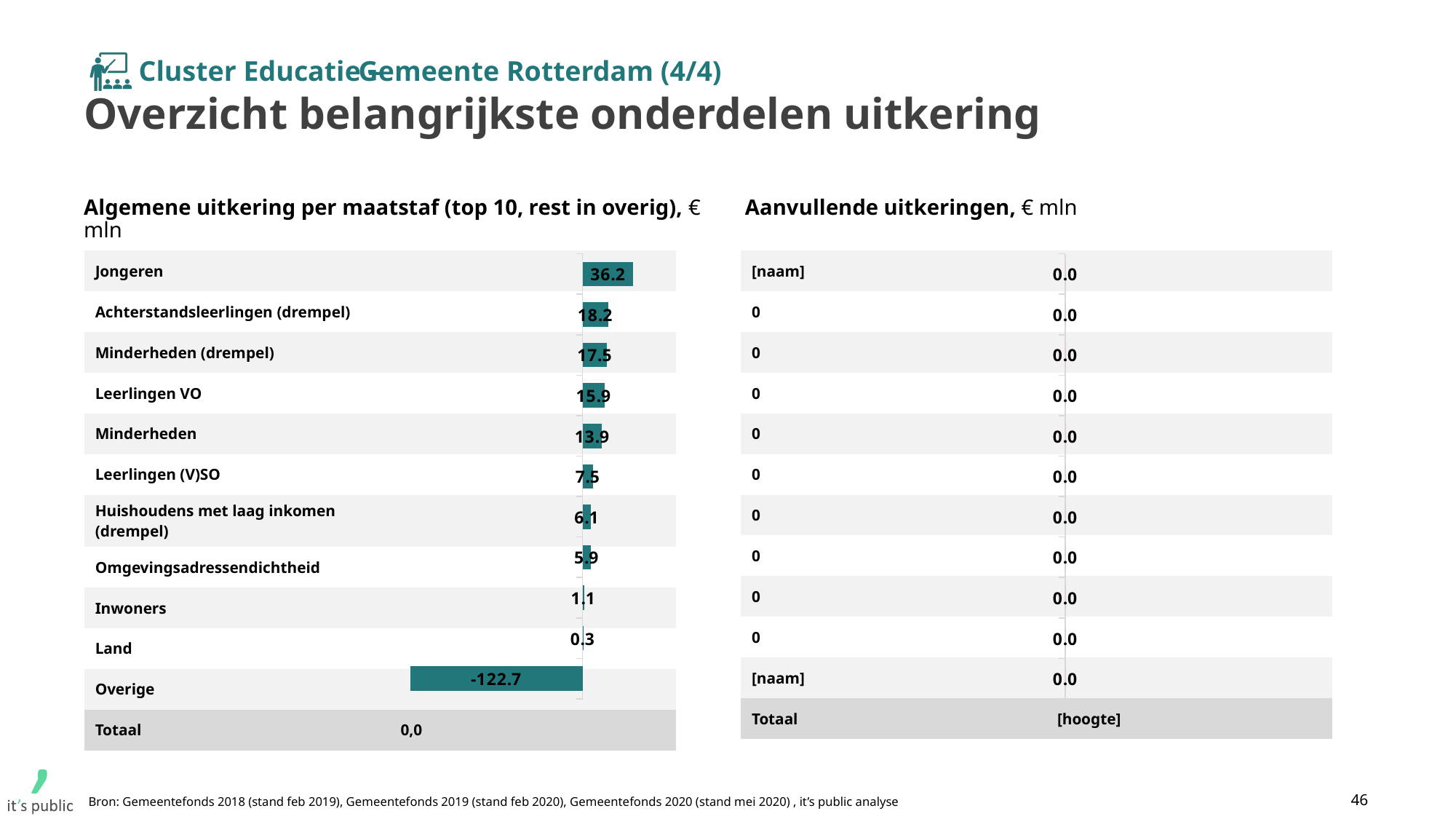
What kind of chart is 'Algemene uitkering per maatstaf (top 10, rest in overig)'? Bar chart In the chart 'Algemene uitkering per maatstaf (top 10, rest in overig)', how many categories are plotted as bars? 11 In the chart 'Algemene uitkering per maatstaf (top 10, rest in overig)', what is the value for Overige? -122.7 In the chart 'Algemene uitkering per maatstaf (top 10, rest in overig)', what is the value for Jongeren? 36.2 In the chart 'Algemene uitkering per maatstaf (top 10, rest in overig)', what is the difference between the values for Jongeren and Achterstandsleerlingen (drempel)? 18.0 In the chart 'Algemene uitkering per maatstaf (top 10, rest in overig)', what is the value for Minderheden (drempel)? 17.5 In the chart 'Algemene uitkering per maatstaf (top 10, rest in overig)', what is the value shown in the Totaal row? 0,0 In the chart 'Algemene uitkering per maatstaf (top 10, rest in overig)', which category has the highest value? Jongeren In the chart 'Algemene uitkering per maatstaf (top 10, rest in overig)', which is larger: Leerlingen VO or Minderheden? Leerlingen VO In the chart 'Aanvullende uitkeringen', what value is shown for every category? 0.0 In the chart 'Algemene uitkering per maatstaf (top 10, rest in overig)', what is the value for Land? 0.3 In the chart 'Algemene uitkering per maatstaf (top 10, rest in overig)', which category has the lowest value? Overige